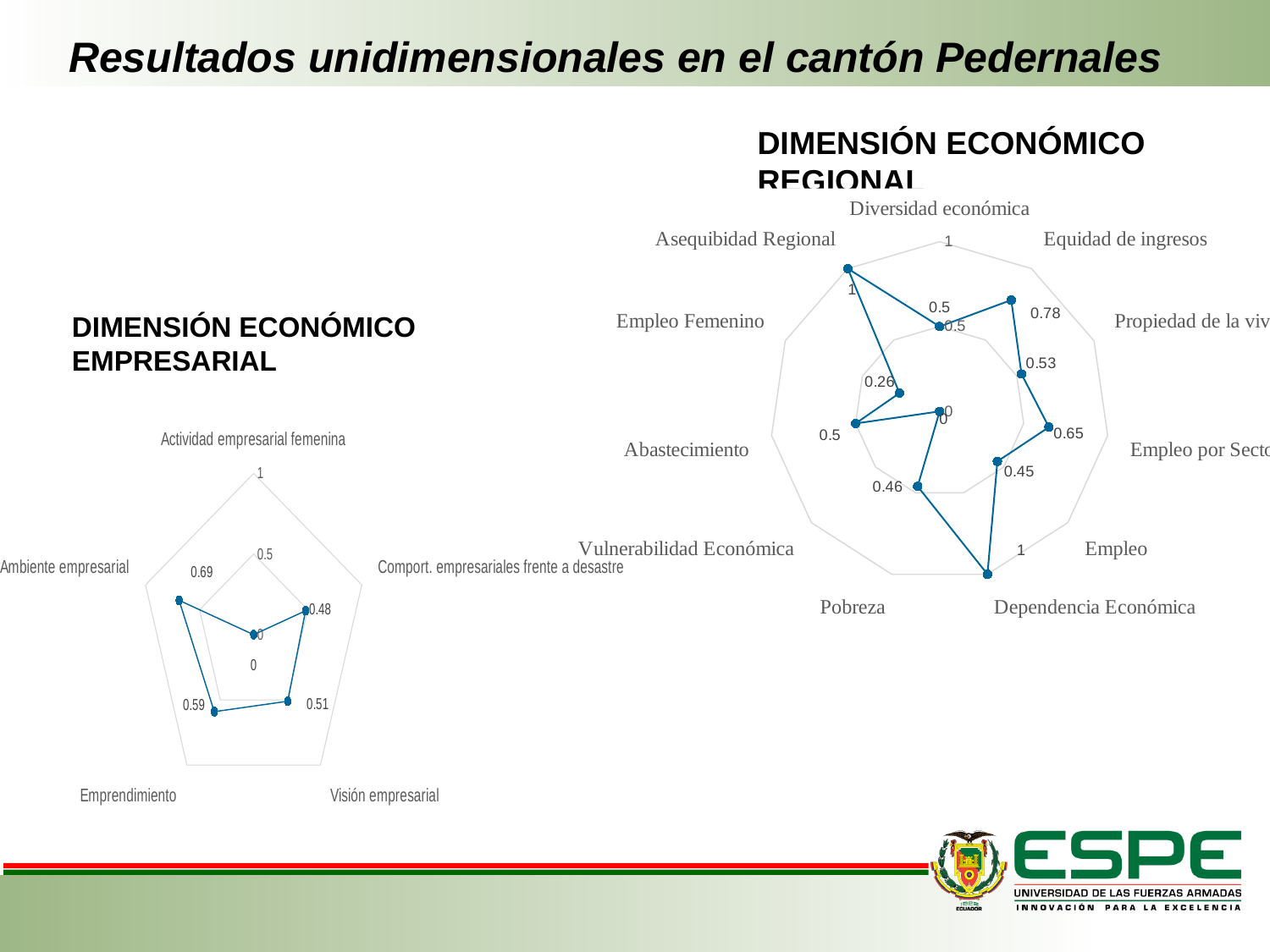
In the DIMENSIÓN ECONÓMICO EMPRESARIAL chart, how many categories are plotted? 5 In the DIMENSIÓN ECONÓMICO REGIONAL chart, what is the value for Dependencia Económica? 1 In the DIMENSIÓN ECONÓMICO REGIONAL chart, what is the value for Vulnerabilidad Económica? 0 In the DIMENSIÓN ECONÓMICO EMPRESARIAL chart, what is the value for Emprendimiento? 0.59 In the DIMENSIÓN ECONÓMICO REGIONAL chart, what is the value for Equidad de ingresos? 0.78 In the DIMENSIÓN ECONÓMICO EMPRESARIAL chart, what is the value for Ambiente empresarial? 0.69 In the DIMENSIÓN ECONÓMICO REGIONAL chart, which is larger, Pobreza or Empleo? Pobreza In the DIMENSIÓN ECONÓMICO EMPRESARIAL chart, what is the difference between Ambiente empresarial and Visión empresarial? 0.18 In the DIMENSIÓN ECONÓMICO REGIONAL chart, how many categories are plotted? 11 What kind of chart is the DIMENSIÓN ECONÓMICO EMPRESARIAL chart? Radar chart In the DIMENSIÓN ECONÓMICO REGIONAL chart, what is the value for Empleo Femenino? 0.26 In the DIMENSIÓN ECONÓMICO EMPRESARIAL chart, which category has the lowest value? Actividad empresarial femenina